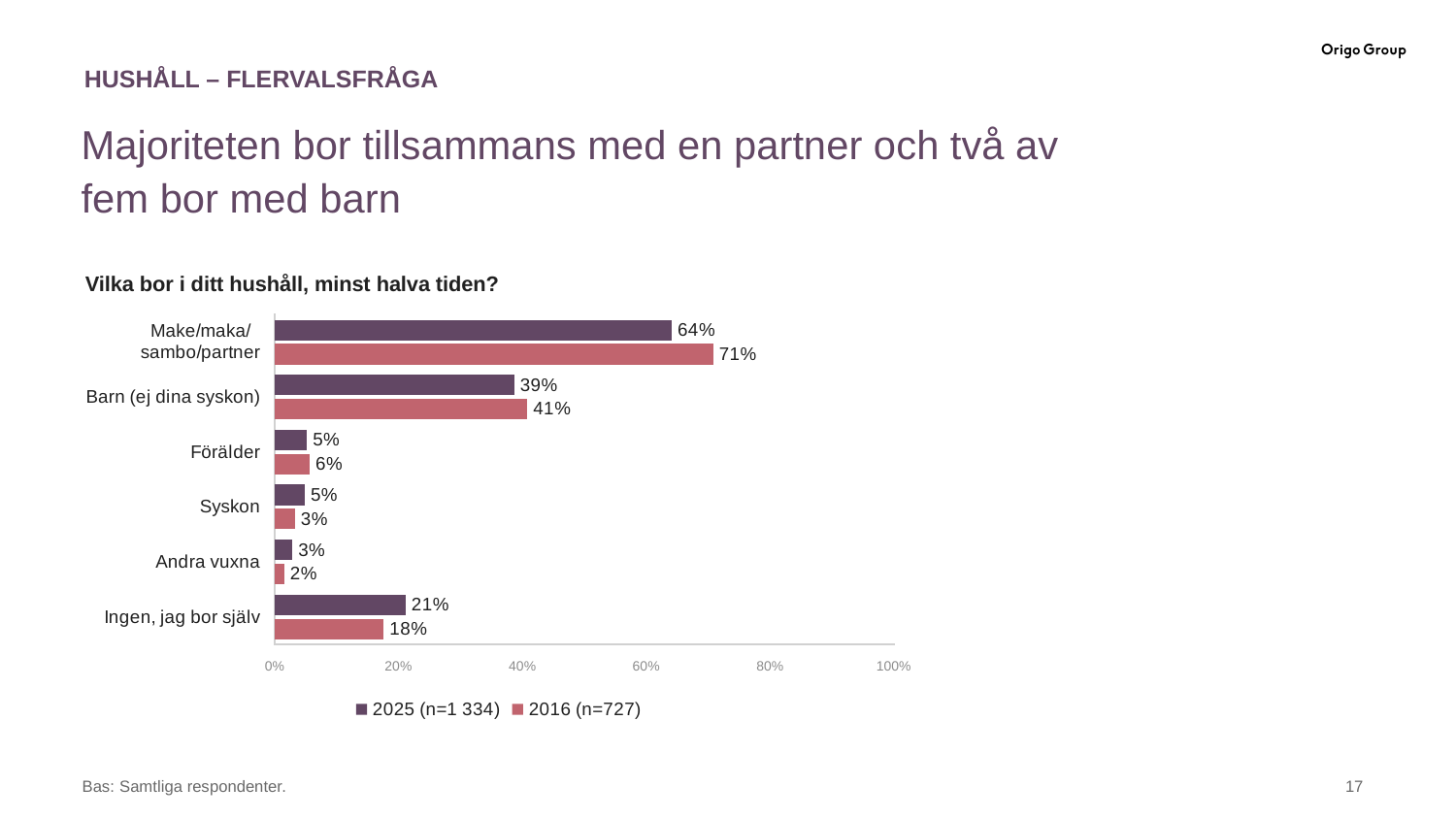
What is the 2025 value for Ingen, jag bor själv? 21% Is the 2025 value for Barn (ej dina syskon) greater or less than 40%? less Which is larger for Syskon, the 2025 value or the 2016 value? 2025 What is the difference between the 2016 and 2025 values for Make/maka/sambo/partner? 7 percentage points Which category has the lowest value in the 2016 series? Andra vuxna How many series does the legend list? 2 What kind of chart is shown on the slide? Bar chart What is the 2016 value for Barn (ej dina syskon)? 41% What is the 2025 value for Make/maka/sambo/partner? 64% Which category has the highest value in the 2025 series? Make/maka/sambo/partner How many categories are shown on the chart? 6 What is the sample size (n) for the 2016 series according to the legend? 727